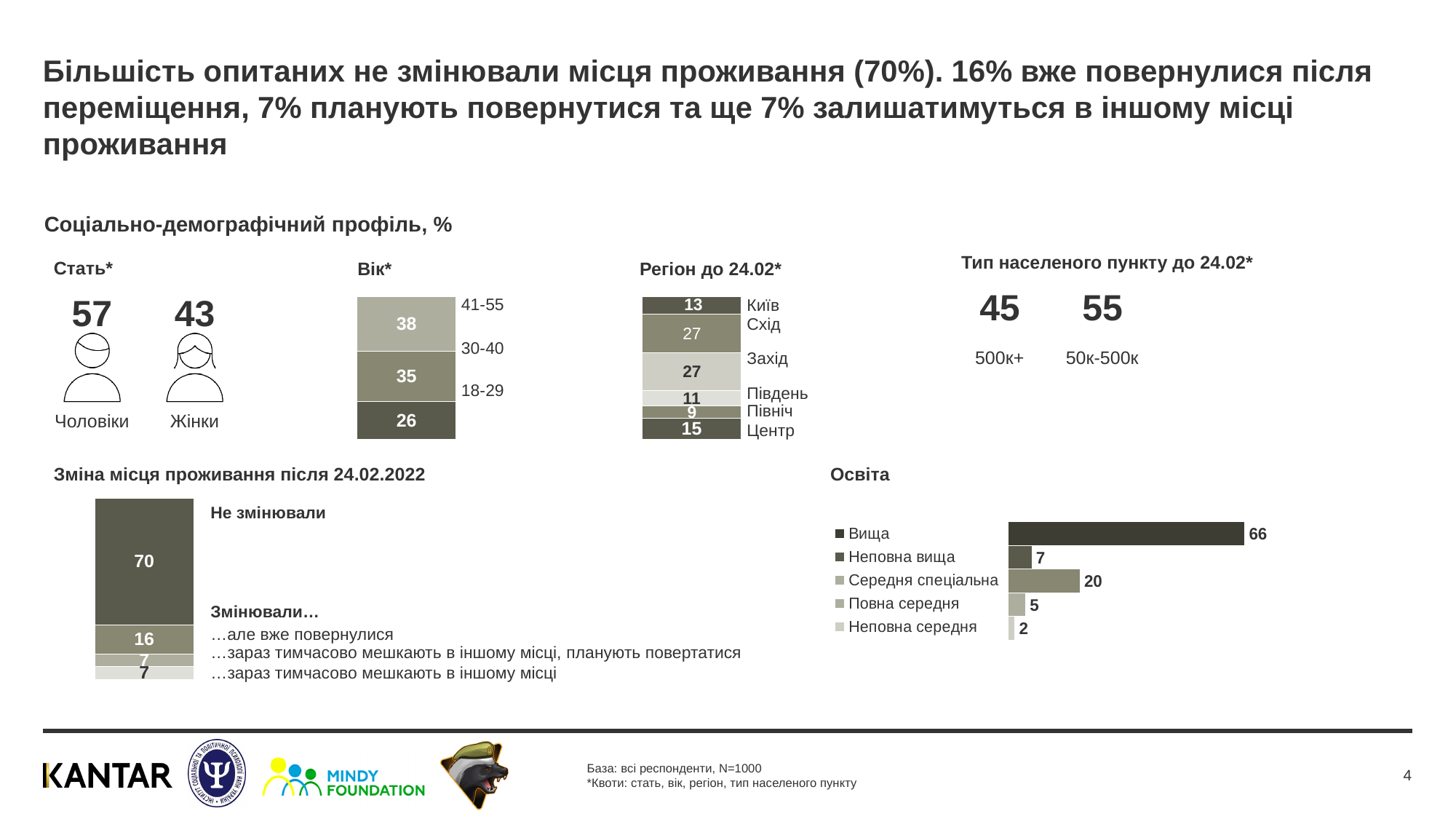
In the Вік* chart, what is the value for the 30-40 age group? 35 In the Освіта chart, which category has the lowest value? Неповна середня What kind of chart is the Освіта chart? bar chart In the Зміна місця проживання після 24.02.2022 chart, what is the value for Не змінювали? 70 In the Регіон до 24.02* chart, which region has the lowest value? Північ In the Освіта chart, which category has the highest value? Вища In the Вік* chart, what is the total of the three stacked segments? 99 In the Регіон до 24.02* chart, what is the value for Південь? 11 In the Стать* chart, which is larger, Чоловіки or Жінки? Чоловіки How many categories are shown in the Освіта chart? 5 In the Освіта chart, what is the value for Вища? 66 In the Освіта chart, what is the difference between the values for Вища and Середня спеціальна? 46